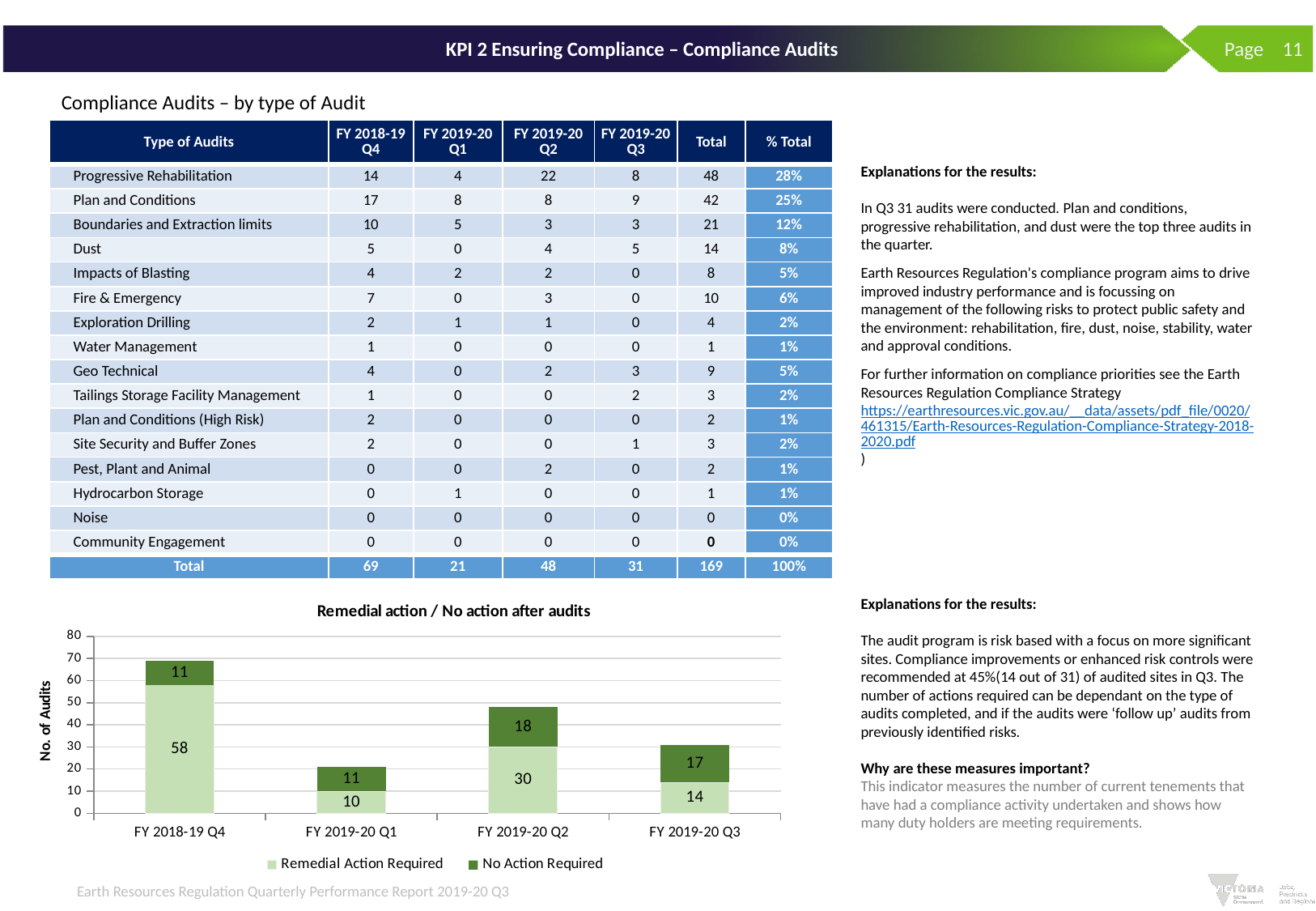
In the "Remedial action / No action after audits" chart, what is the value for Remedial Action Required in FY 2019-20 Q3? 14 How many series does the legend of the "Remedial action / No action after audits" chart list? 2 How many quarters are shown on the x axis of the "Remedial action / No action after audits" chart? 4 In the "Remedial action / No action after audits" chart, which is larger in FY 2019-20 Q1: Remedial Action Required or No Action Required? No Action Required What type of chart is shown under the title "Remedial action / No action after audits"? Stacked bar chart In the "Remedial action / No action after audits" chart, which quarter has the lowest value for Remedial Action Required? FY 2019-20 Q1 In the "Remedial action / No action after audits" chart, which quarter has the highest value for Remedial Action Required? FY 2018-19 Q4 In the "Remedial action / No action after audits" chart, what is the difference between Remedial Action Required and No Action Required in FY 2019-20 Q3? 3 What is the y-axis label of the "Remedial action / No action after audits" chart? No. of Audits In the "Remedial action / No action after audits" chart, what is the total of the stacked bar for FY 2019-20 Q2? 48 In the "Remedial action / No action after audits" chart, what is the value for No Action Required in FY 2019-20 Q2? 18 In the "Remedial action / No action after audits" chart, what is the value for Remedial Action Required in FY 2018-19 Q4? 58